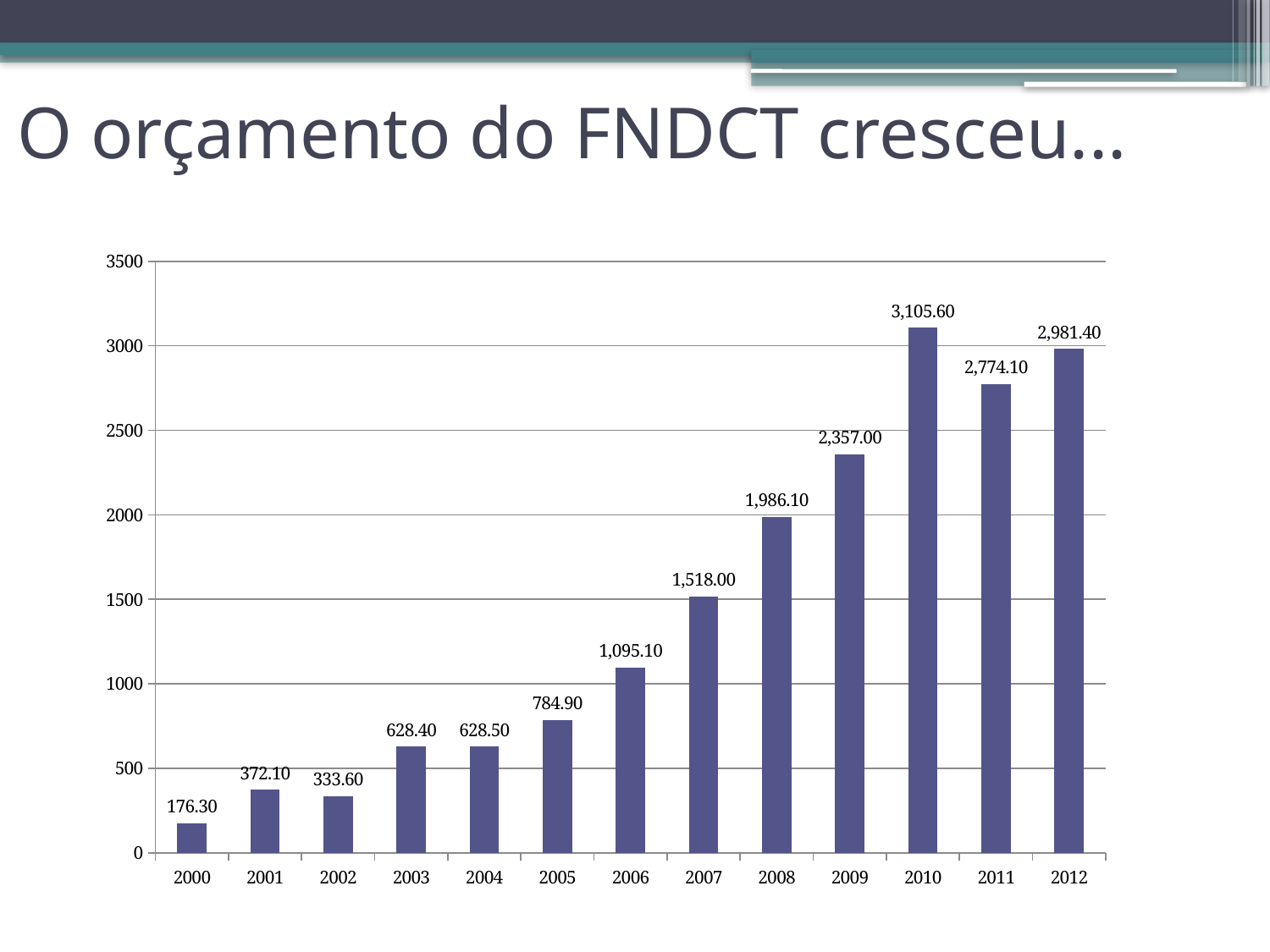
What kind of chart is shown on the slide? bar chart What is the value for 2010? 3,105.60 What is the value for 2000? 176.30 What is the value for 2007? 1,518.00 What is the difference between the values for 2010 and 2009? 748.60 Do the values generally rise or fall from 2000 to 2010? rise Is the value for 2008 greater or less than 1500? greater What is the difference between the values for 2012 and 2011? 207.30 Which year has the highest value? 2010 How many years are shown on the x axis? 13 Which year has the lowest value? 2000 Which is larger, the value for 2001 or the value for 2002? 2001